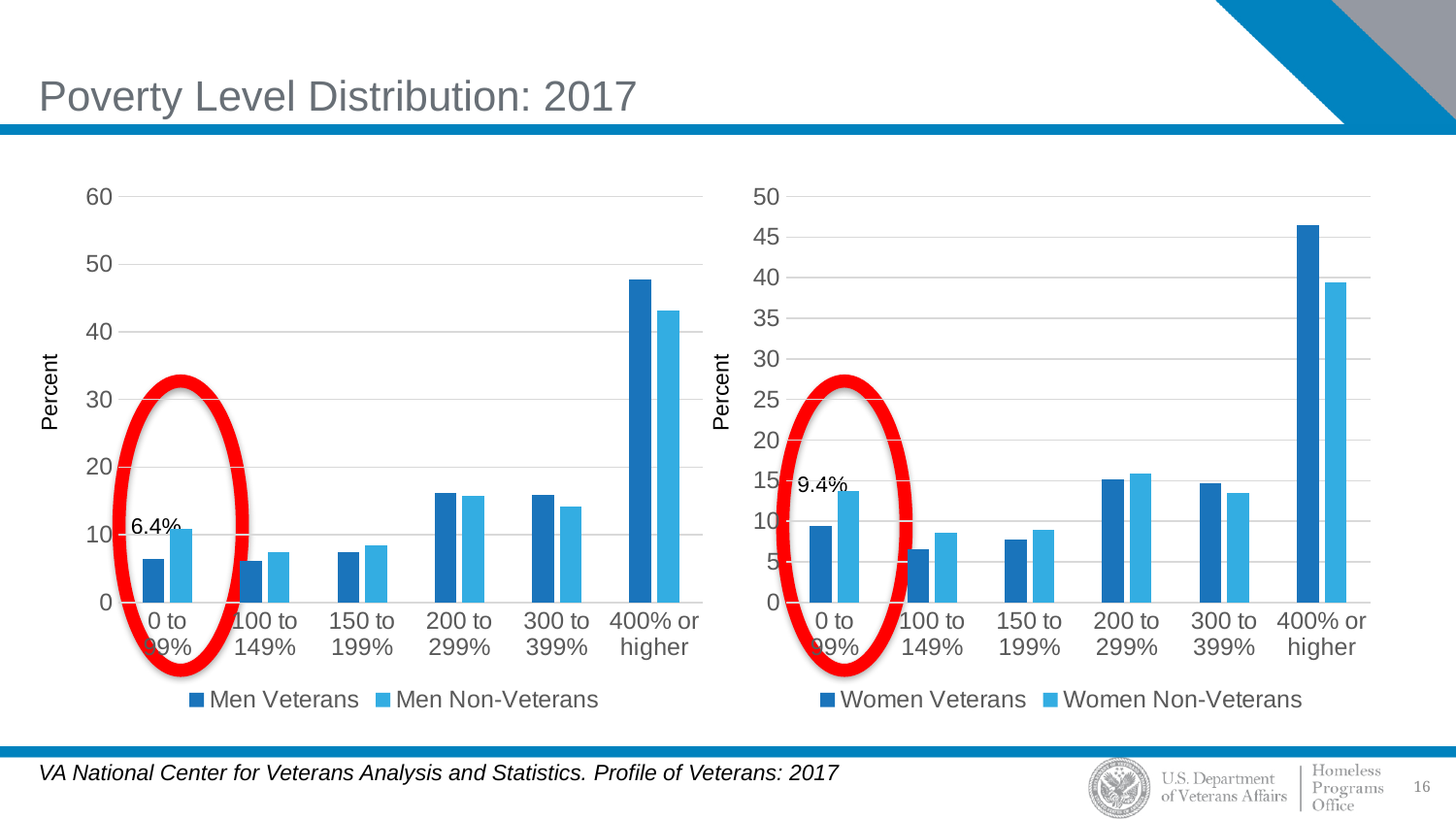
In the left chart (Men), which category has the highest value for Men Veterans? 400% or higher What is the label on the y axis of the right chart (Women)? Percent How many poverty level categories are shown on the x axis of the left chart (Men)? 6 In the right chart (Women), is the value for Women Veterans in the 100 to 149% category greater or less than 10? less In the right chart (Women), in the 400% or higher category, which is larger: Women Veterans or Women Non-Veterans? Women Veterans In the right chart (Women), which category has the lowest value for Women Veterans? 100 to 149% How many series does the legend of the right chart (Women) list? 2 In the left chart (Men), what is the value for Men Veterans in the 0 to 99% category? 6.4% In the right chart (Women), what is the value for Women Veterans in the 0 to 99% category? 9.4% What type of chart is the left chart (Men)? Bar chart In the left chart (Men), is the value for Men Veterans in the 400% or higher category greater or less than 40? greater In the left chart (Men), in the 0 to 99% category, which is larger: Men Veterans or Men Non-Veterans? Men Non-Veterans